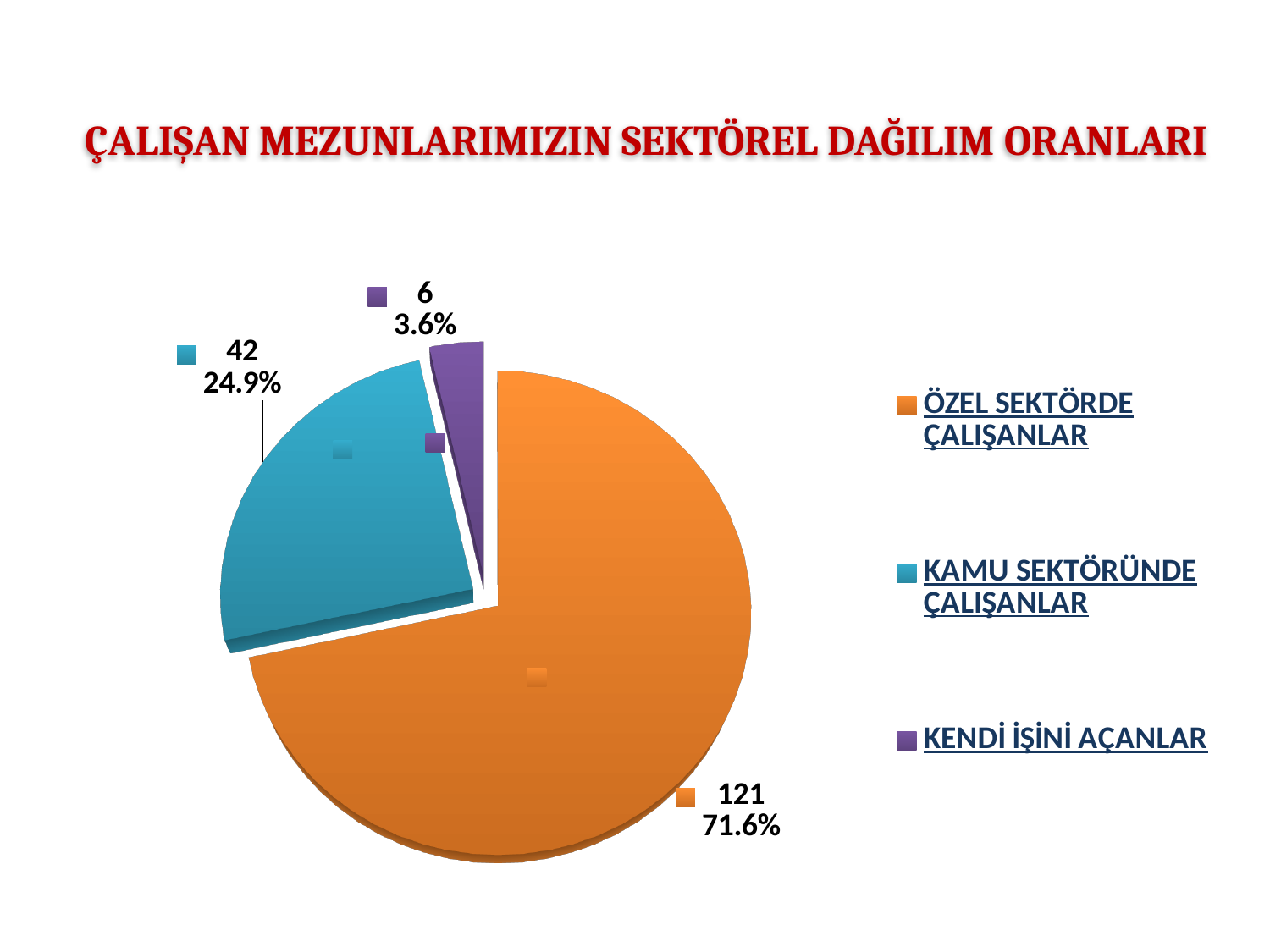
What percentage share of the pie does KENDİ İŞİNİ AÇANLAR have? 3.6% What percentage share of the pie does ÖZEL SEKTÖRDE ÇALIŞANLAR have? 71.6% What is the value for KENDİ İŞİNİ AÇANLAR? 6 What is the value for ÖZEL SEKTÖRDE ÇALIŞANLAR? 121 Which category has the smallest slice of the pie? KENDİ İŞİNİ AÇANLAR What is the title of the chart on the slide? ÇALIŞAN MEZUNLARIMIZIN SEKTÖREL DAĞILIM ORANLARI What is the value for KAMU SEKTÖRÜNDE ÇALIŞANLAR? 42 What percentage share of the pie does KAMU SEKTÖRÜNDE ÇALIŞANLAR have? 24.9% What is the difference between the values for ÖZEL SEKTÖRDE ÇALIŞANLAR and KAMU SEKTÖRÜNDE ÇALIŞANLAR? 79 What kind of chart is shown on the slide? Pie chart Which category has the largest slice of the pie? ÖZEL SEKTÖRDE ÇALIŞANLAR How many categories does the pie chart have? 3